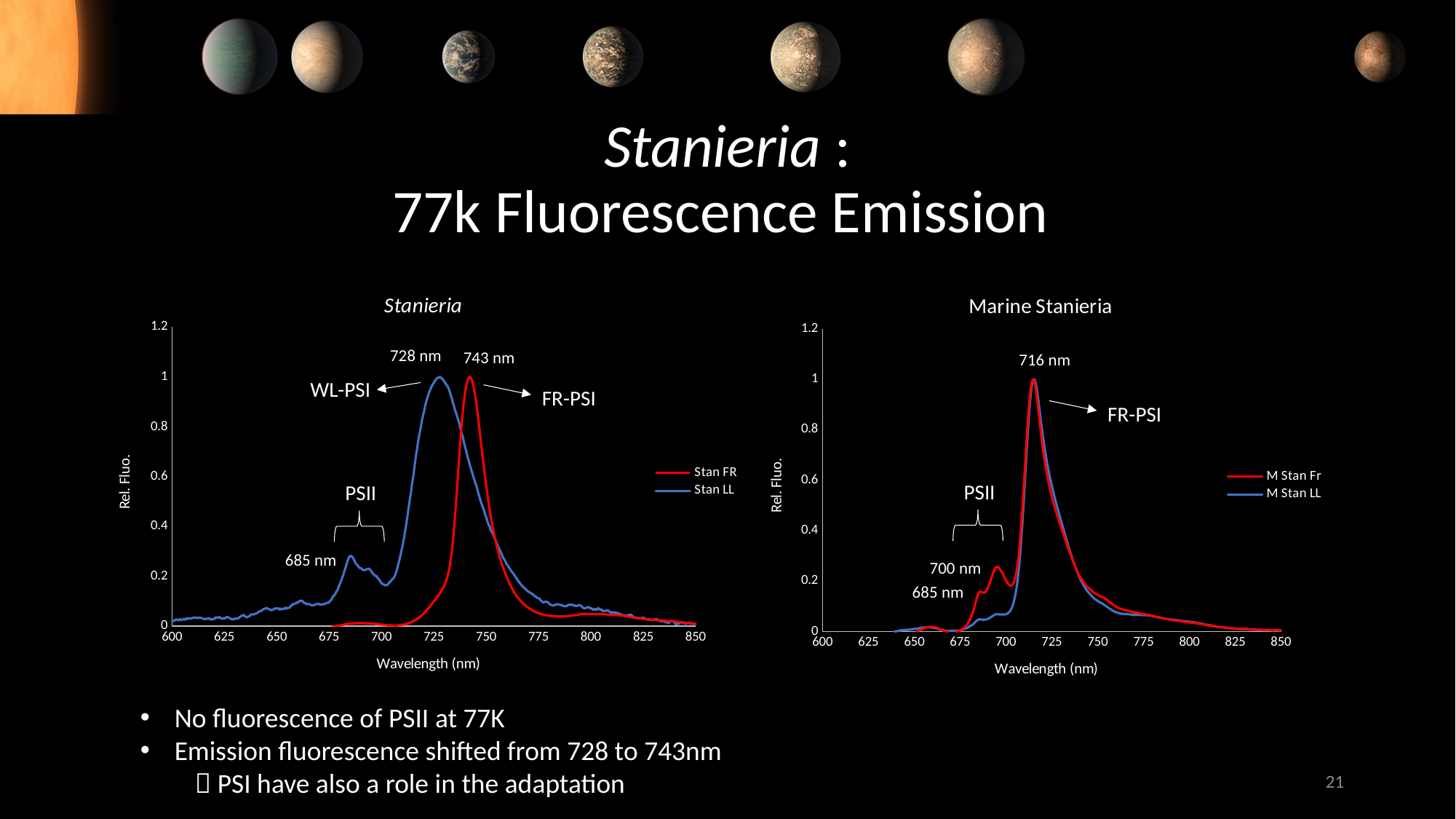
In the Stanieria chart, at 685 nm, which series has the larger value, Stan FR or Stan LL? Stan LL How many series does the legend of the Stanieria chart list? 2 In the Marine Stanieria chart, at what wavelength is the FR-PSI peak labelled? 716 nm What is the label of the x axis on the Marine Stanieria chart? Wavelength (nm) In the Stanieria chart, is the Stan LL value at 685 nm greater or less than 0.6? less In the Stanieria chart, at what wavelength is the peak of the Stan LL (WL-PSI) curve labelled? 728 nm In the Stanieria chart, is the Stan FR value at its 743 nm peak greater or less than 0.8? greater In the Stanieria chart, at what wavelength is the peak of the Stan FR (FR-PSI) curve labelled? 743 nm What kind of chart is the left chart titled Stanieria? line chart What are the two series named in the legend of the Marine Stanieria chart? M Stan Fr and M Stan LL In the Marine Stanieria chart, is the M Stan Fr value at its 716 nm peak greater or less than 0.8? greater